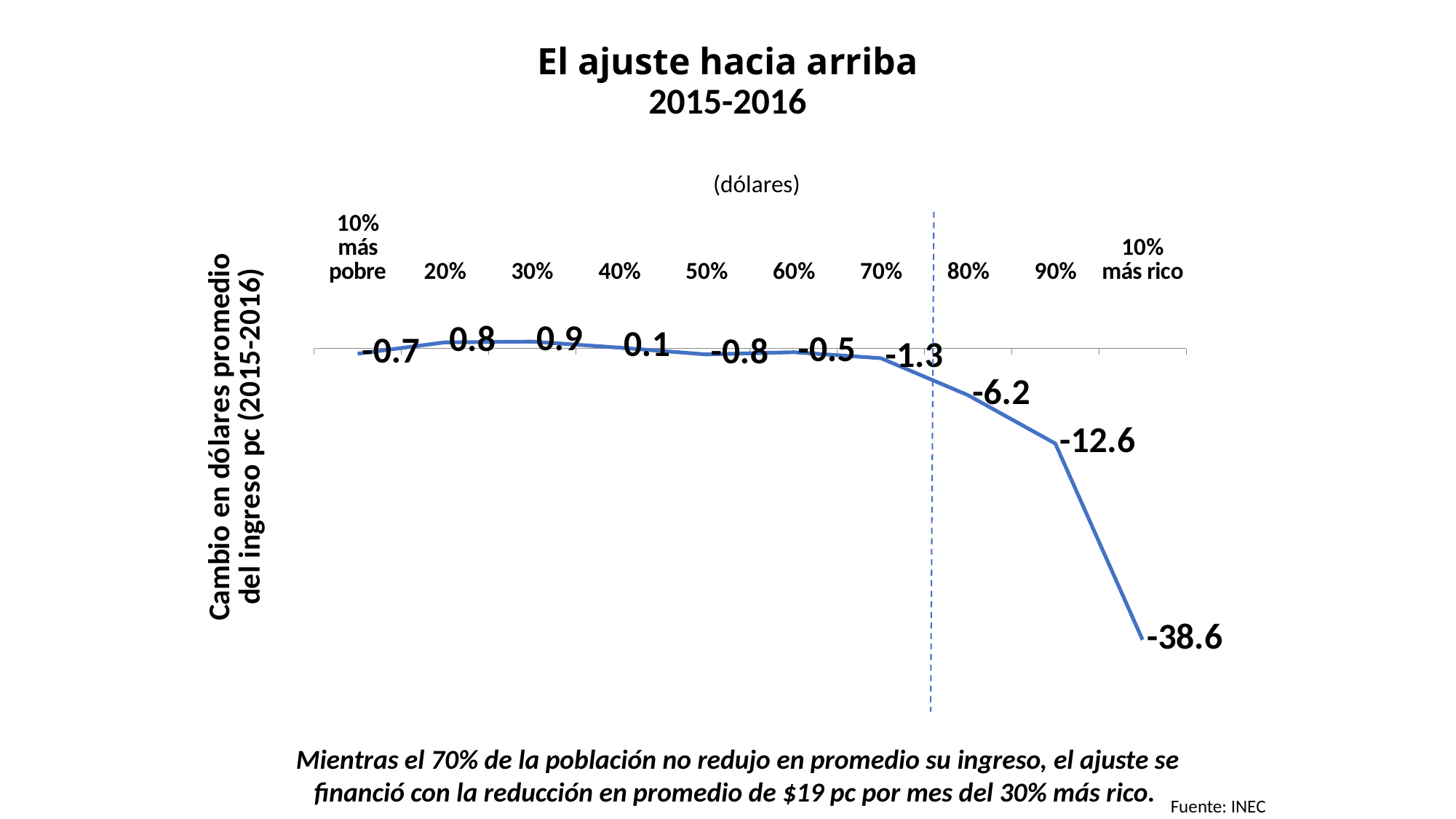
Which decile has the highest value? 30% What is the value for the 80% decile? -6.2 What is the value for the 10% más rico decile? -38.6 Which is larger, the value for the 20% decile or the value for the 50% decile? 20% What is the value for the 30% decile? 0.9 Do the values rise or fall from the 70% decile to the 10% más rico decile? fall What is the difference between the values for the 90% decile and the 10% más rico decile? 26.0 What is the value for the 10% más pobre decile? -0.7 Which decile has the lowest value? 10% más rico How many deciles are plotted on the chart? 10 What is the title of the chart? El ajuste hacia arriba 2015-2016 What kind of chart is shown? line chart